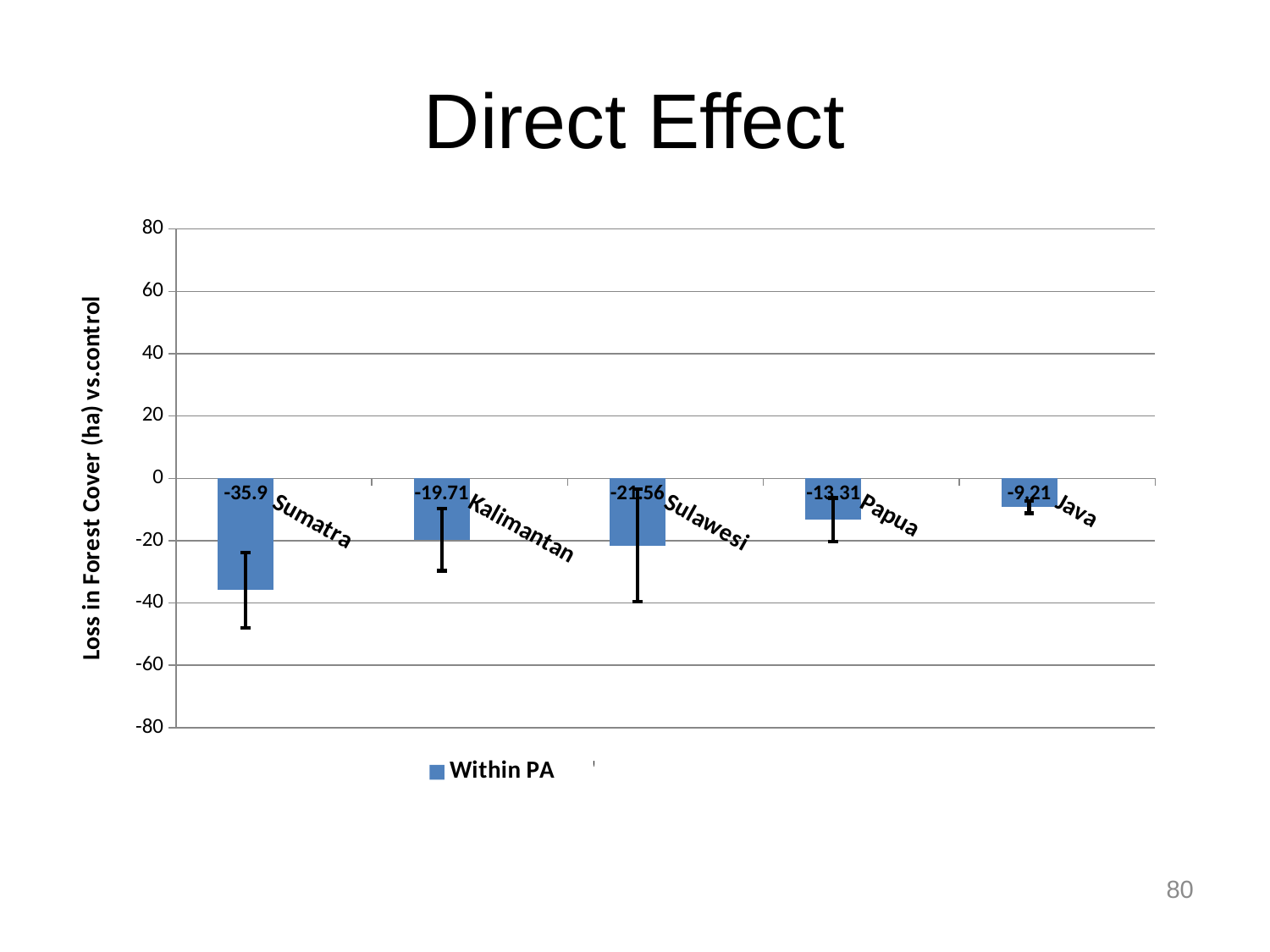
What is the difference between the values for Kalimantan and Papua? 6.4 What is the difference between the values for Sumatra and Java? 26.69 What is the value for Kalimantan? -19.71 What kind of chart is shown? Bar chart What is the value for Java? -9.21 What series name does the legend show? Within PA What is the value for Sumatra? -35.9 What is the value for Papua? -13.31 Which has the larger (less negative) value, Papua or Kalimantan? Papua How many categories are shown on the x axis? 5 Which category has the lowest (most negative) value? Sumatra Which category has the highest (least negative) value? Java